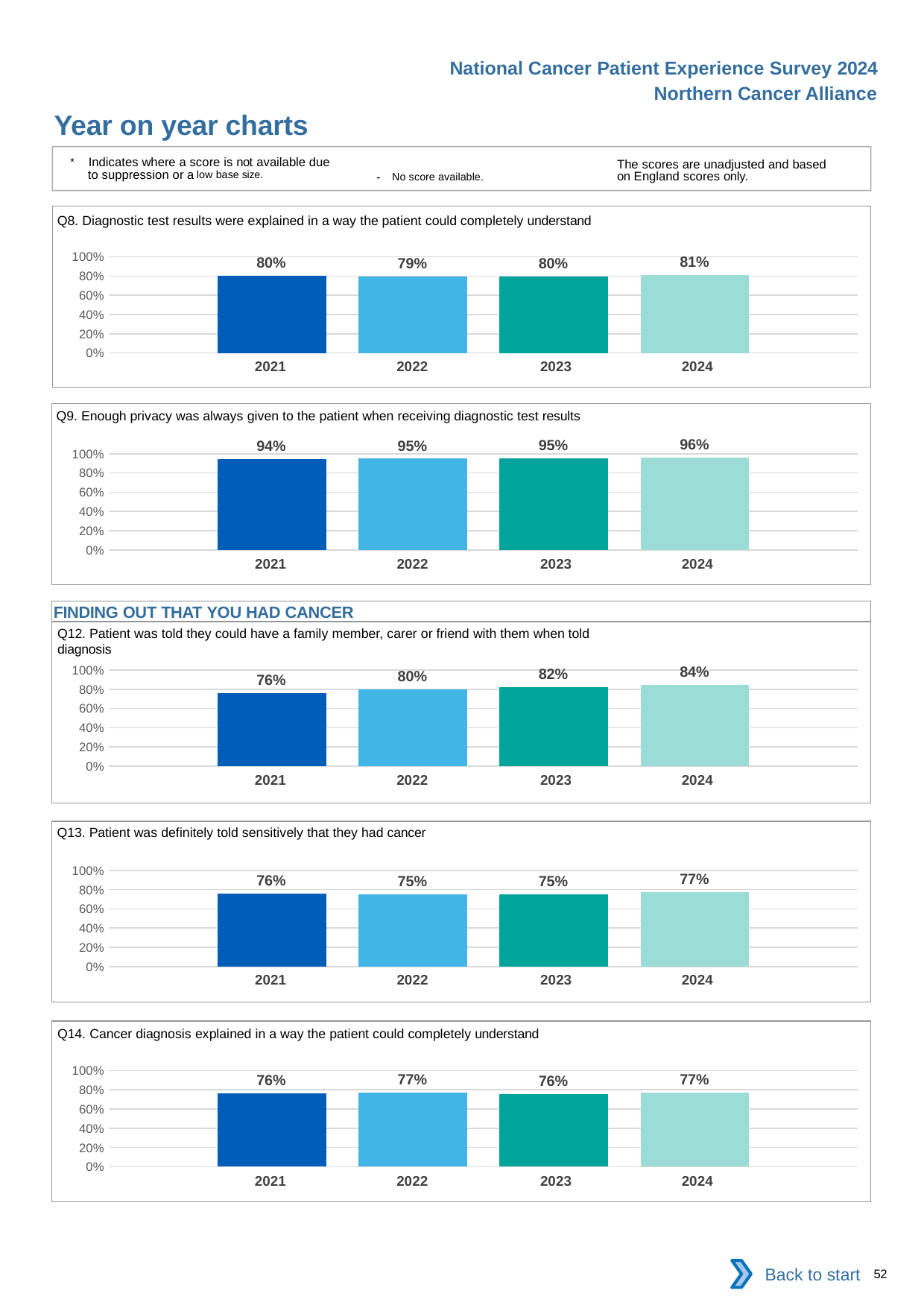
In the Q12 chart, do the values rise or fall from 2021 to 2024? rise In the Q12 chart, what is the difference between the 2024 and 2021 values? 8 percentage points In the Q8 chart, what is the value for 2024? 81% In the Q9 chart, is the value for 2024 greater or less than 80%? greater How many years are shown in the Q8 chart? 4 In the Q13 chart, what is the value for 2022? 75% In the Q14 chart, what is the value for 2023? 76% In the Q12 chart, which year has the highest value? 2024 In the Q9 chart, what is the value for 2021? 94% In the Q12 chart, which year has the lowest value? 2021 In the Q13 chart, which year has the highest value? 2024 What kind of chart is the Q9 chart? bar chart